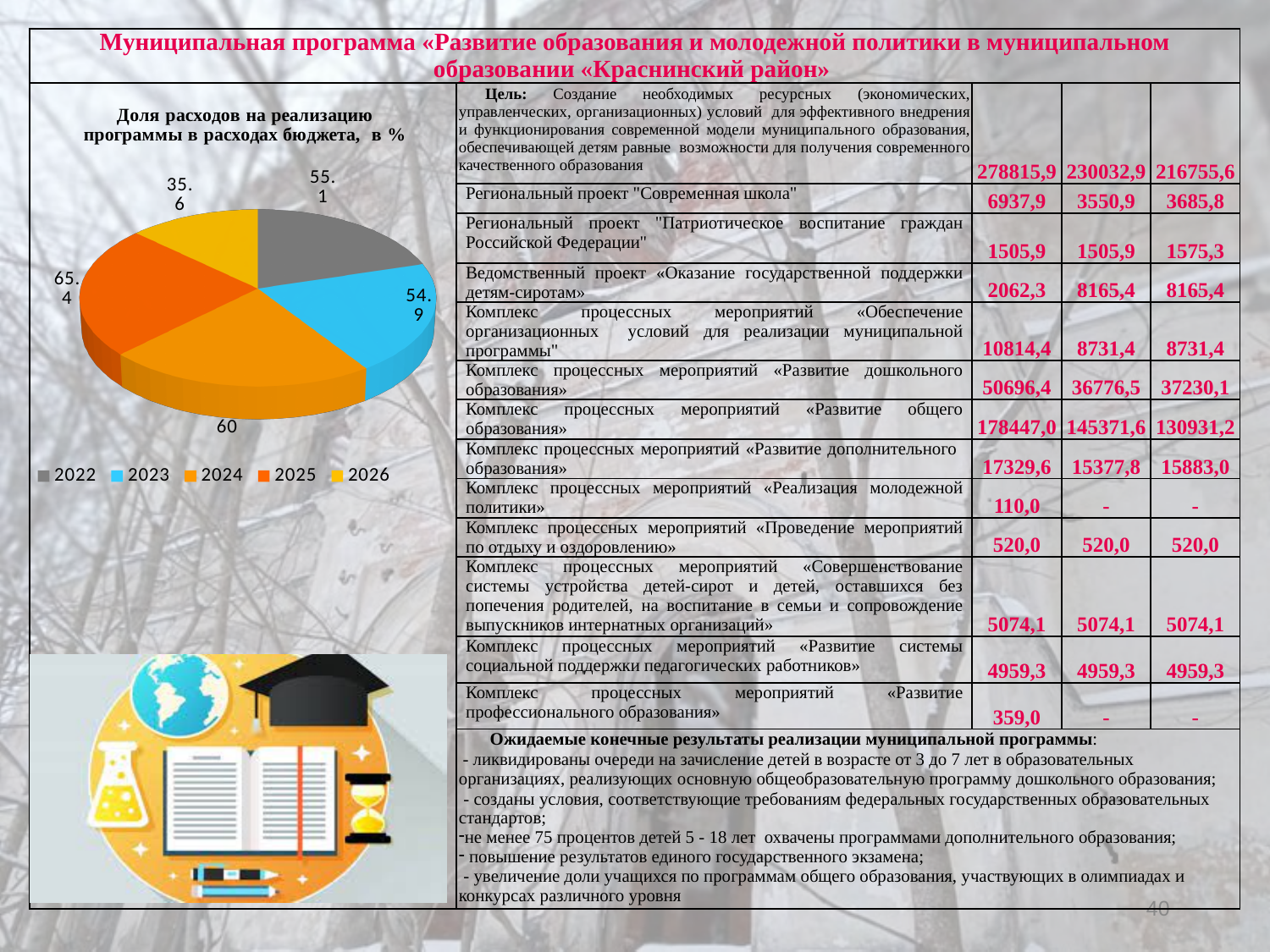
What is the title of the pie chart? Доля расходов на реализацию программы в расходах бюджета, в % What value is shown for 2024 in the pie chart? 60 In the pie chart, what is the difference between the values for 2025 and 2026? 29.8 What value is shown for 2023 in the pie chart? 54.9 How many entries does the pie chart's legend list? 5 How many slices does the pie chart have? 5 What value is shown for 2025 in the pie chart? 65.4 Which year has the smallest value in the pie chart? 2026 Which year has the largest value in the pie chart? 2025 What kind of chart is shown on the left of the slide? pie chart What value is shown for 2026 in the pie chart? 35.6 What value is shown for 2022 in the pie chart? 55.1